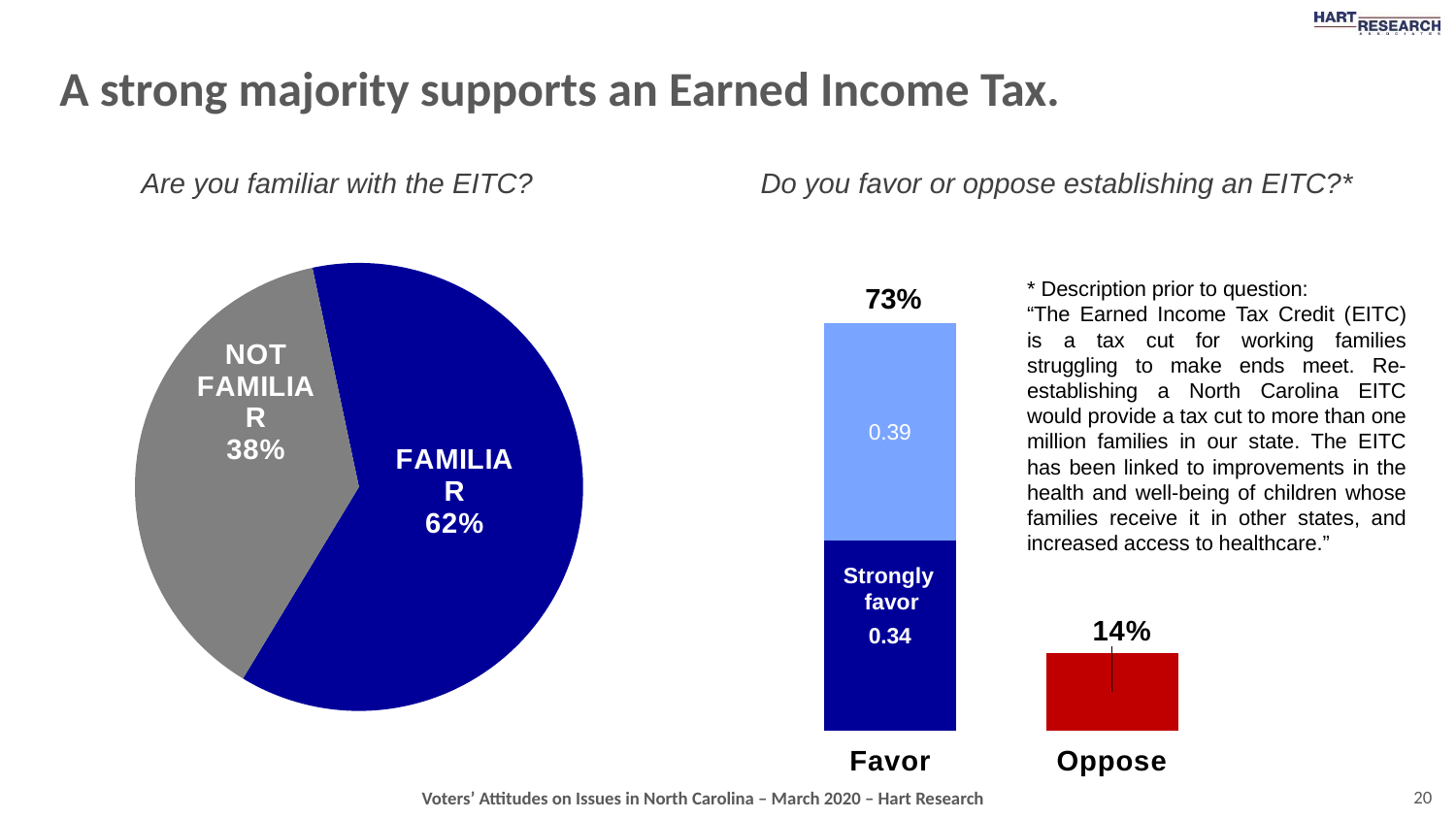
What kind of chart is used for 'Are you familiar with the EITC?'? Pie chart In the pie chart 'Are you familiar with the EITC?', which slice is larger, Familiar or Not Familiar? Familiar In the chart 'Do you favor or oppose establishing an EITC?', what is the value for Oppose? 14% In the pie chart 'Are you familiar with the EITC?', how many slices are there? 2 In the chart 'Do you favor or oppose establishing an EITC?', what is the value of the lighter blue segment on top of the Favor bar? 0.39 In the chart 'Do you favor or oppose establishing an EITC?', what is the total value of the Favor bar? 73% In the pie chart 'Are you familiar with the EITC?', what share of respondents are not familiar with the EITC? 38% In the pie chart 'Are you familiar with the EITC?', what is the difference between the Familiar and Not Familiar shares? 24 percentage points In the pie chart 'Are you familiar with the EITC?', what share of respondents are familiar with the EITC? 62% What kind of chart is used for 'Do you favor or oppose establishing an EITC?'? Bar chart In the chart 'Do you favor or oppose establishing an EITC?', what is the value of the 'Strongly favor' segment? 0.34 In the chart 'Do you favor or oppose establishing an EITC?', which bar is taller, Favor or Oppose? Favor